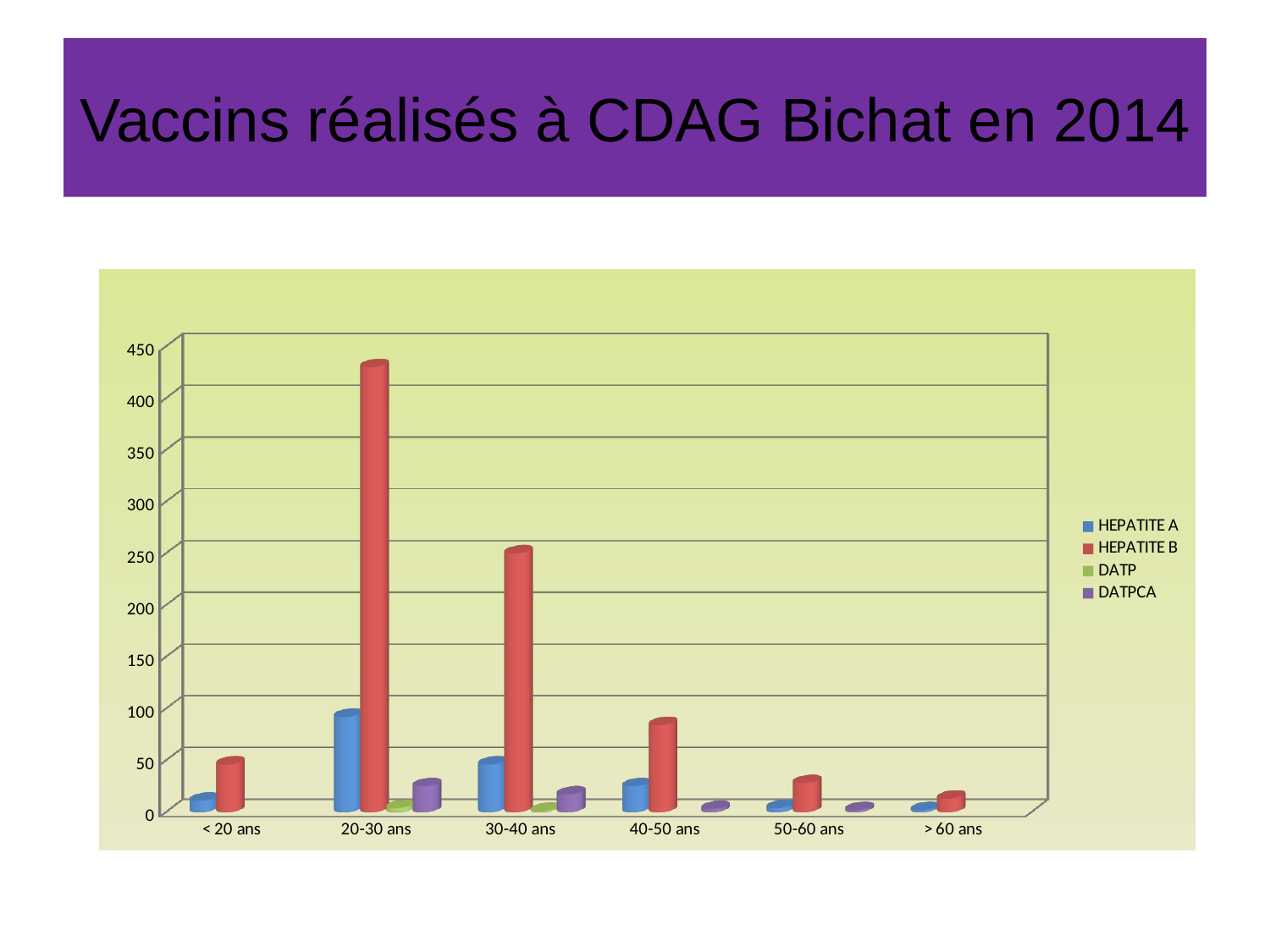
How many series does the legend list? 4 Which age category has the highest value for HEPATITE B? 20-30 ans Is the value for HEPATITE B in the 20-30 ans category greater or less than 400? greater Is the value for HEPATITE A in the 20-30 ans category greater or less than 100? less How many age categories are shown on the x axis? 6 Which is larger for HEPATITE B: the value for 30-40 ans or the value for 40-50 ans? 30-40 ans What kind of chart is shown on the slide? bar chart Is the value for HEPATITE B in the 40-50 ans category greater or less than 100? less From the 20-30 ans category onward, do the HEPATITE B values rise or fall as age increases? fall What is the title of the slide containing the chart? Vaccins réalisés à CDAG Bichat en 2014 Which age category has the highest value for HEPATITE A? 20-30 ans